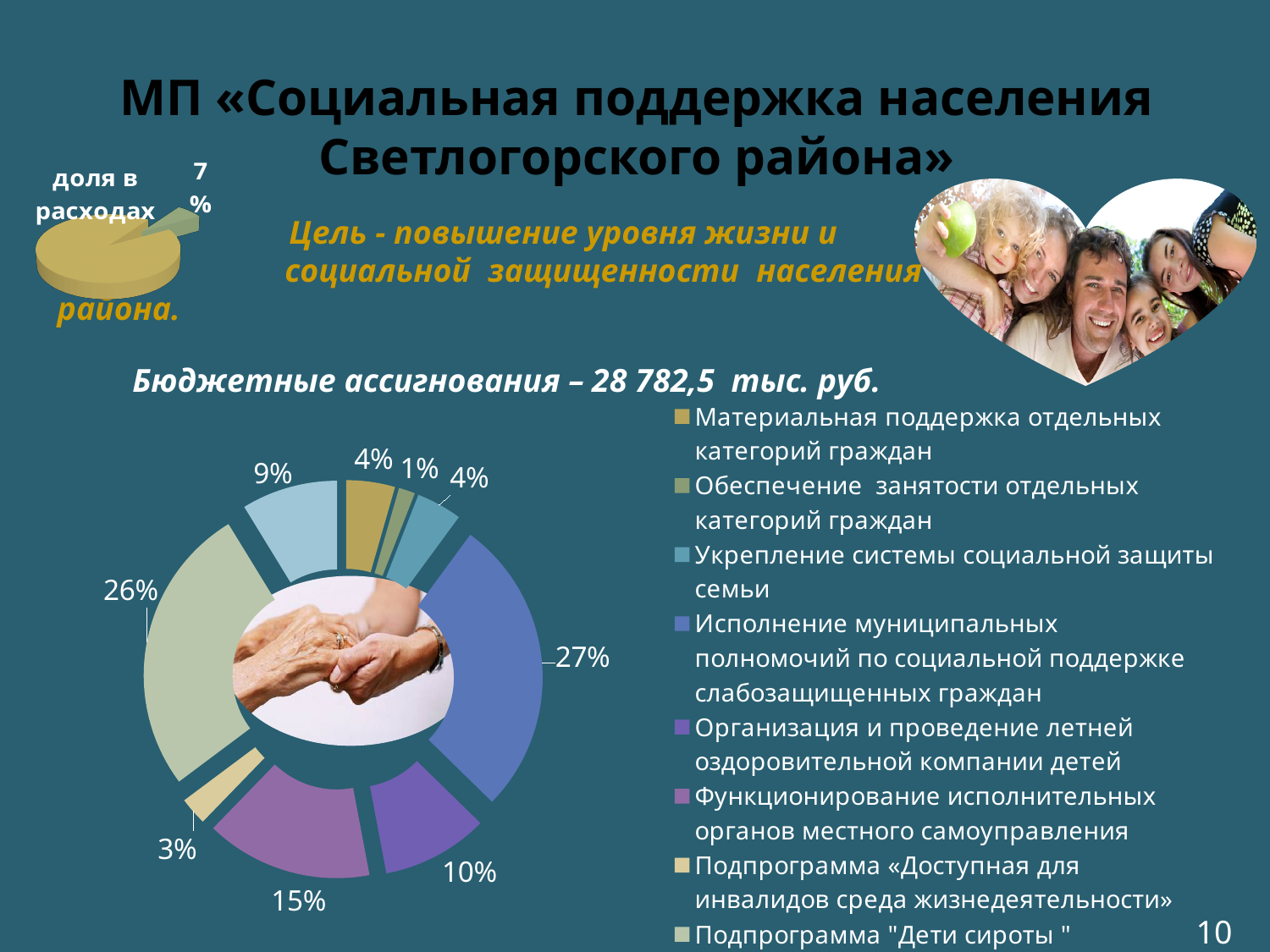
What is the title of the small pie chart at the top left of the slide? доля в расходах How many entries does the legend to the right of the large doughnut chart list? 8 In the large doughnut chart, what is the difference between the 15% slice and the 3% slice? 12% In the small pie chart at the top left titled 'доля в расходах', what percentage is shown for the separated slice? 7% What budget allocation amount is stated above the large doughnut chart? 28 782,5 тыс. руб. How many slices does the large doughnut chart have? 9 In the large doughnut chart, what is the difference between the 27% slice and the 26% slice? 1% What kind of chart is the large chart on the lower left of the slide? Doughnut (pie) chart In the large doughnut chart, what is the largest percentage shown? 27% In the large doughnut chart, what is the smallest percentage shown? 1% In the large doughnut chart, which is larger: the 15% slice or the 10% slice? 15% In the large doughnut chart, what percentage is shown for the blue slice labelled 'Исполнение муниципальных полномочий по социальной поддержке слабозащищенных граждан'? 27%